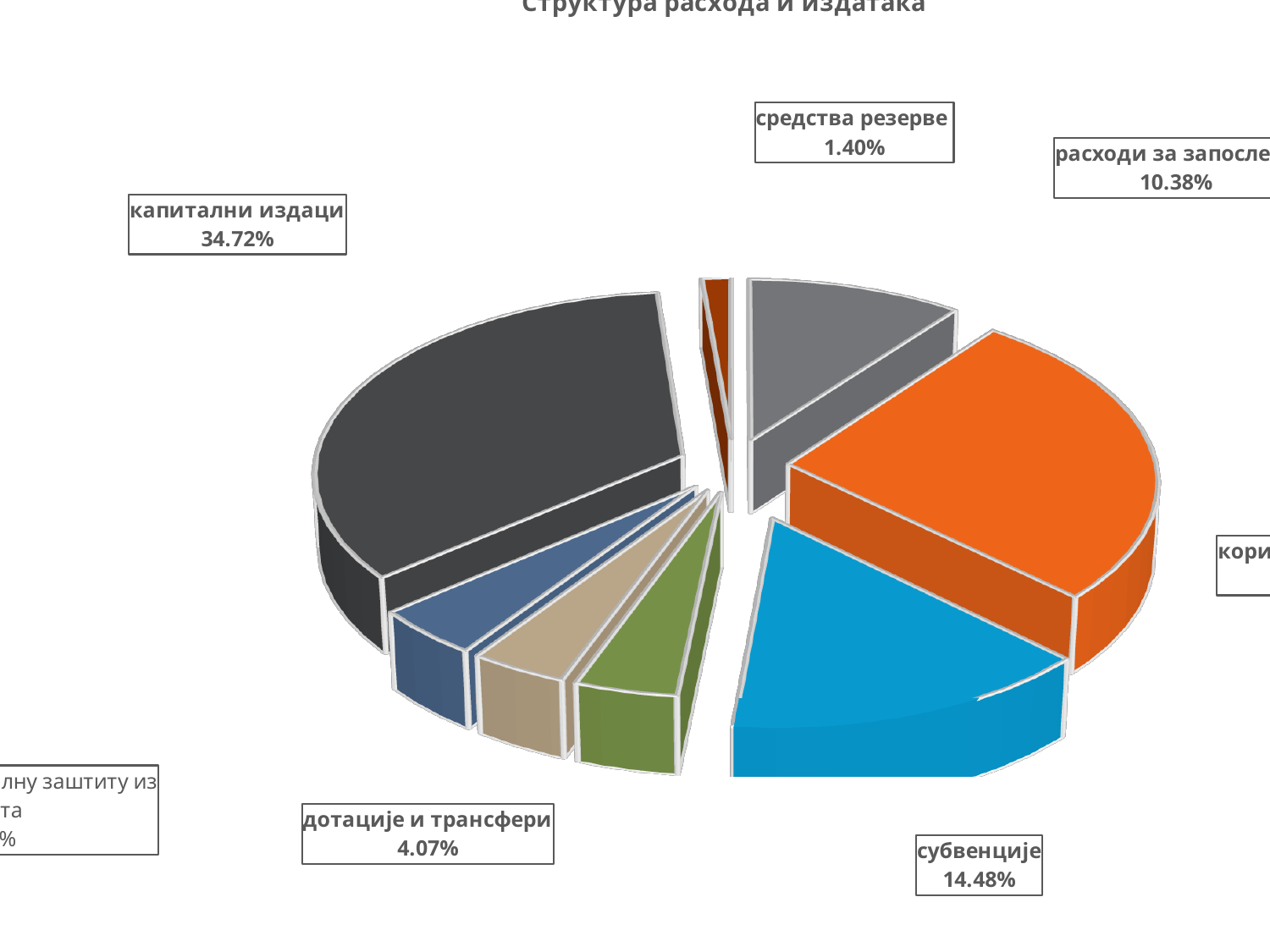
What colour is the капитални издаци slice? dark gray What is the title of the chart? Структура расхода и издатака What share of the pie is дотације и трансфери? 4.07% How many slices does the pie chart have? 8 Which is larger, капитални издаци or субвенције? капитални издаци What is the difference between the shares of капитални издаци and субвенције? 20.24% Which labelled slice has the smallest share? средства резерве What is the difference between the shares of субвенције and дотације и трансфери? 10.41% What share of the pie is капитални издаци? 34.72% What share of the pie is средства резерве? 1.40% What share of the pie is субвенције? 14.48% What kind of chart is shown on the slide? pie chart